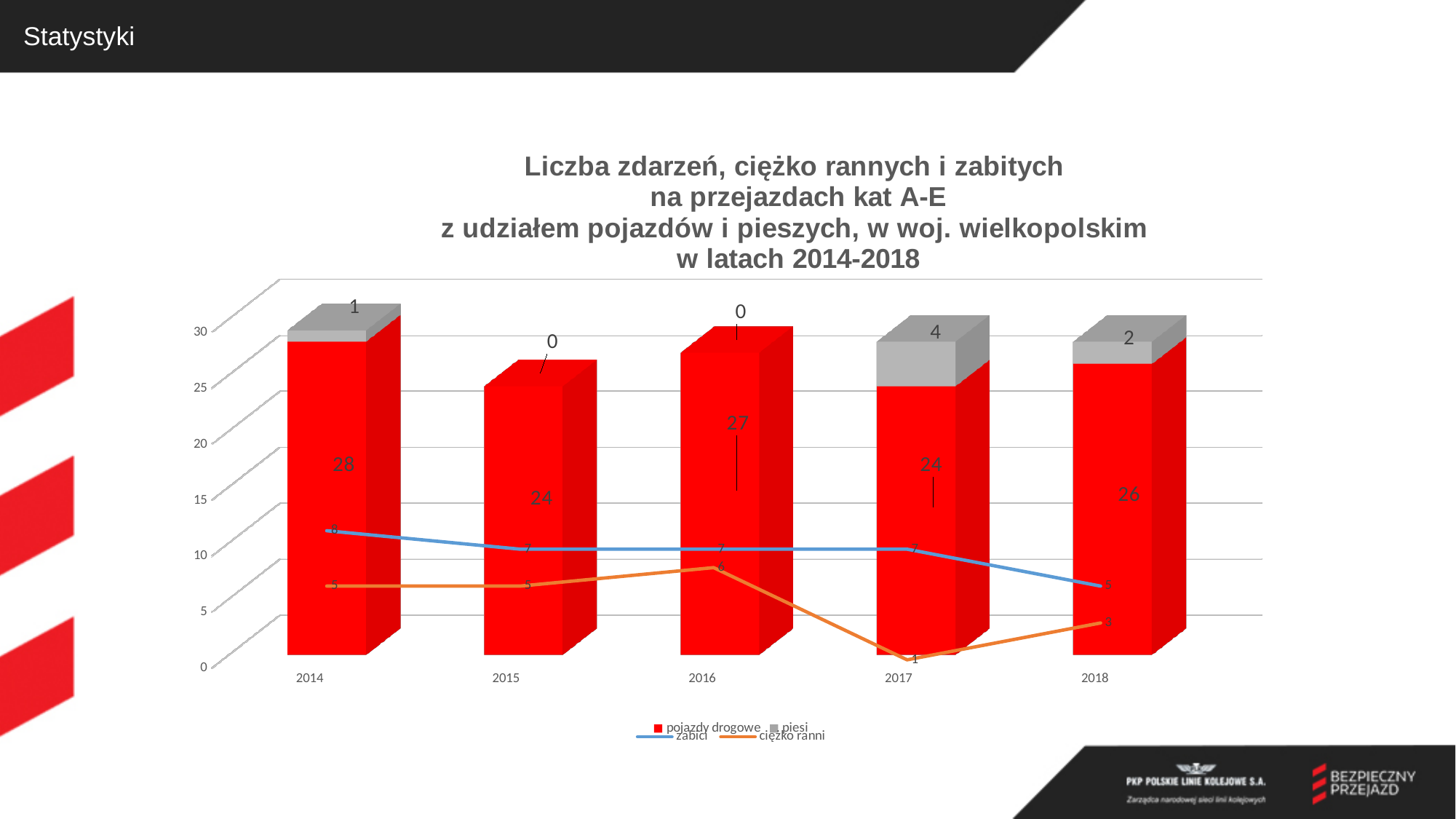
What is the value for zabici in 2018? 5 How many years are shown on the x axis? 5 Which is larger: the piesi value for 2017 or for 2018? 2017 What is the difference between the pojazdy drogowe values for 2014 and 2015? 4 In which year is the value for ciężko ranni lowest? 2017 In which year is the value for pojazdy drogowe highest? 2014 What is the value for piesi in 2017? 4 What is the value for ciężko ranni in 2016? 6 What is the value for pojazdy drogowe in 2014? 28 What is the total of the stacked bar for 2017 (pojazdy drogowe plus piesi)? 28 How many series does the legend list? 4 Does the zabici line rise or fall from 2014 to 2018? fall